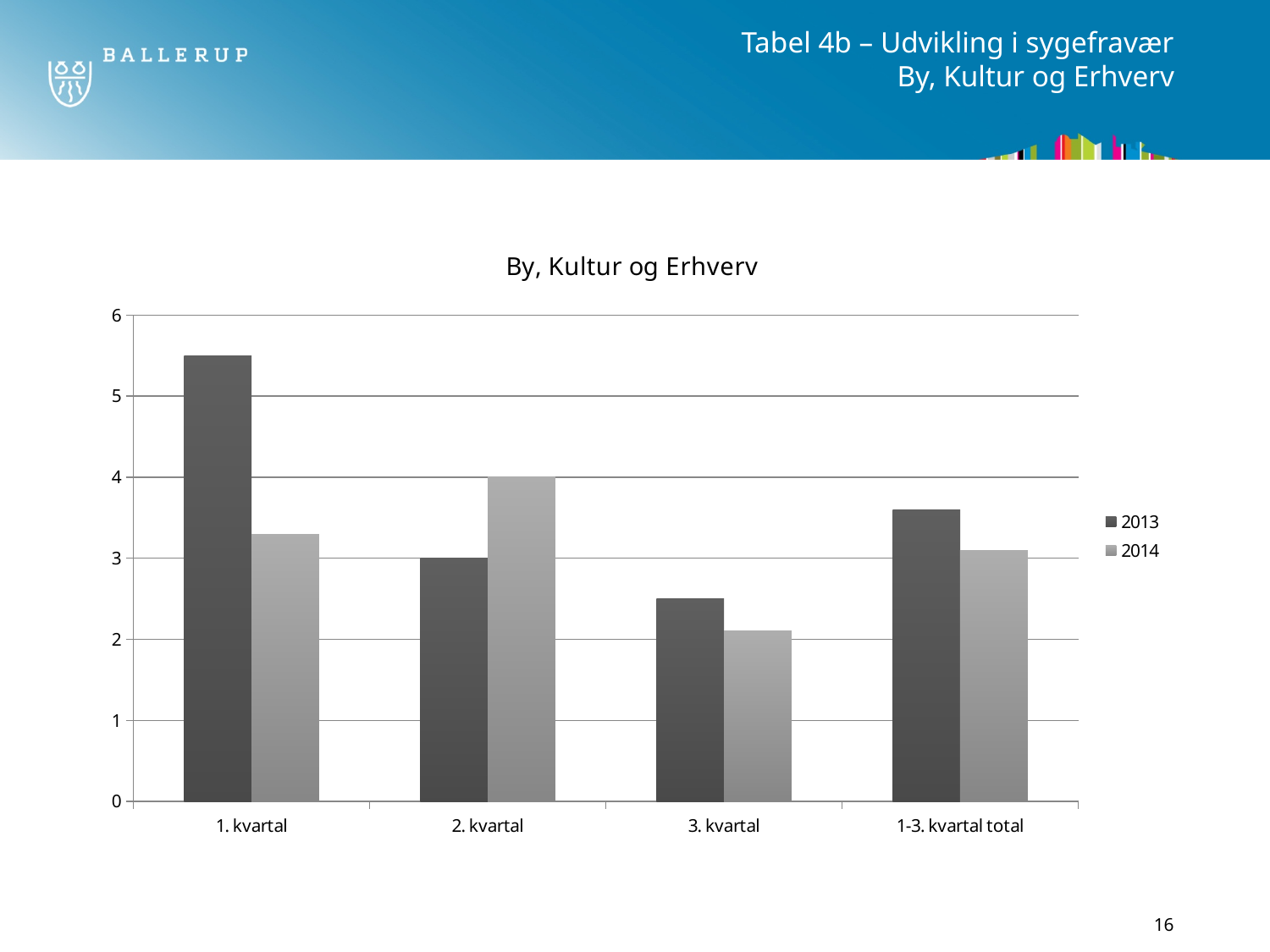
Is the value for 2013 in 1. kvartal greater or less than 5? greater What is the title of the chart? By, Kultur og Erhverv What type of chart is shown on the slide? bar chart Which category has the highest value for the 2013 series? 1. kvartal How many series does the legend list? 2 In 1-3. kvartal total, which series has the larger value, 2013 or 2014? 2013 Is the value for 2014 in 3. kvartal greater or less than 3? less In 2. kvartal, which series has the larger value, 2013 or 2014? 2014 Which category has the lowest value for the 2014 series? 3. kvartal What is the value for 2014 in 2. kvartal? 4 How many categories are shown on the x axis? 4 What is the value for 2013 in 2. kvartal? 3